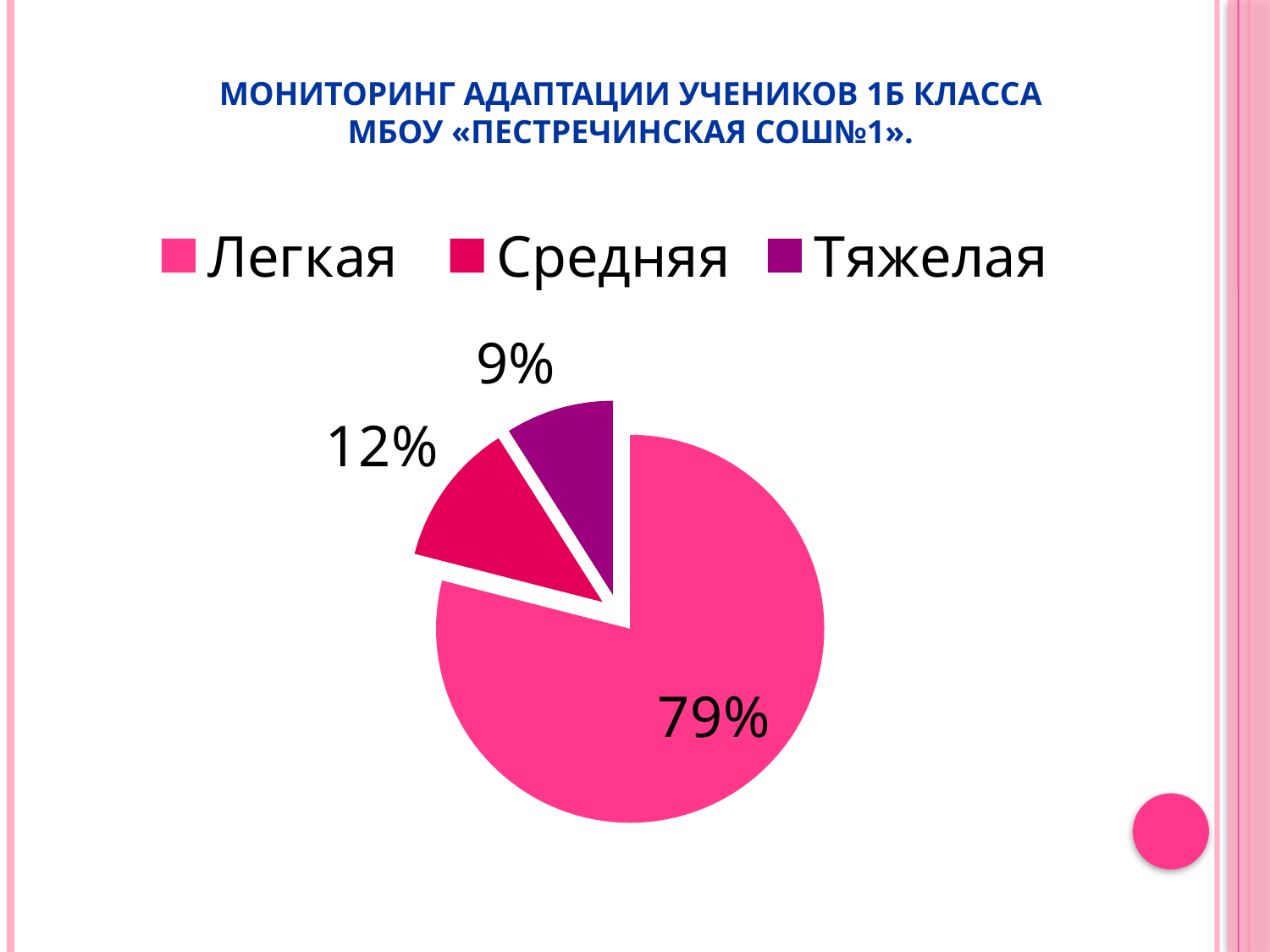
Which category has the largest slice of the pie? Легкая How many entries does the legend list? 3 What share of the pie does Средняя have? 12% Which legend entry is shown in purple? Тяжелая What is the difference in percentage points between Средняя and Тяжелая? 3 What kind of chart is shown on the slide? pie chart What share of the pie does Легкая have? 79% Which category has the smallest slice of the pie? Тяжелая What is the difference in percentage points between Легкая and Средняя? 67 How many categories does the pie chart have? 3 Which is larger, the slice for Средняя or the slice for Тяжелая? Средняя What share of the pie does Тяжелая have? 9%